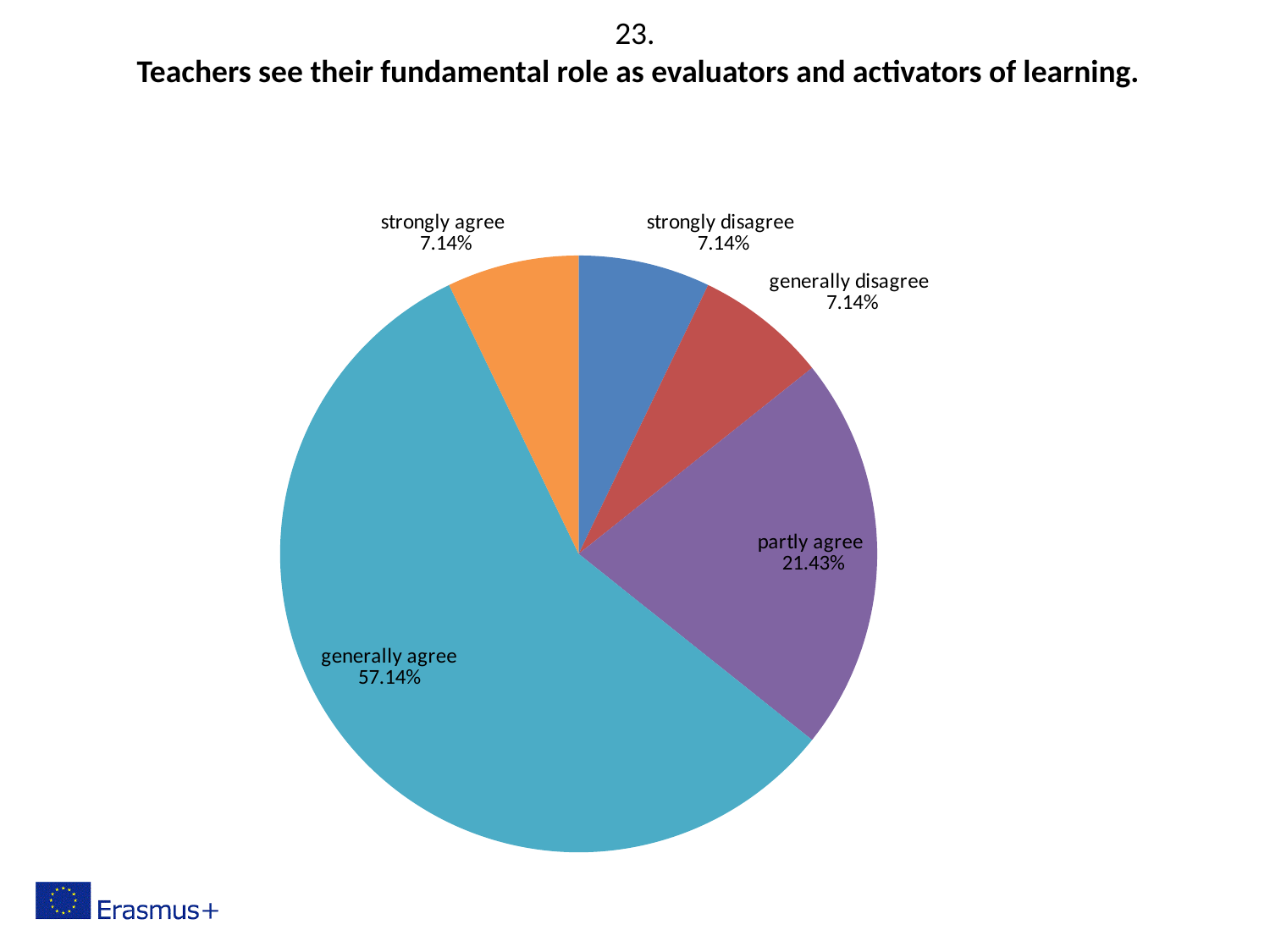
What percentage of respondents chose 'strongly agree'? 7.14% What percentage of respondents chose 'strongly disagree'? 7.14% What is the combined share of 'generally agree' and 'partly agree'? 78.57% What kind of chart is shown on the slide? pie chart What is the difference in percentage points between 'generally agree' and 'partly agree'? 35.71 What percentage of respondents chose 'generally agree'? 57.14% Which response category has the largest share of the pie? generally agree What colour is the 'generally agree' slice? teal Which is larger, the share for 'partly agree' or the share for 'generally disagree'? partly agree What percentage of respondents chose 'partly agree'? 21.43% How many slices does the pie chart have? 5 What is the title of the chart on the slide? Teachers see their fundamental role as evaluators and activators of learning.